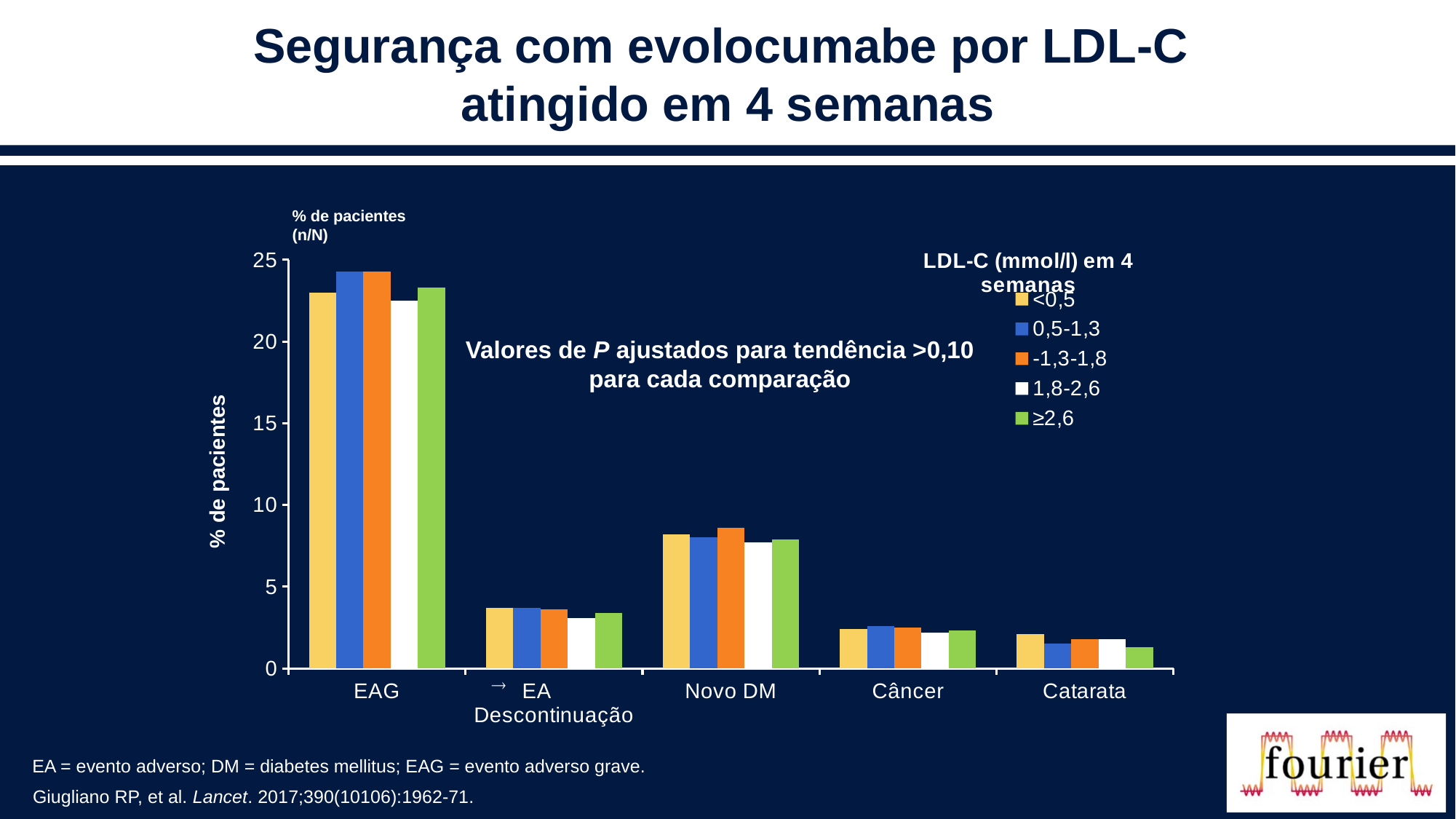
In the <0,5 series, which is larger: the value for EAG or the value for Novo DM? EAG Which category has the tallest bars in the chart? EAG Which category has the shortest bars in the chart? Catarata Is the value for Novo DM in the ≥2,6 series greater or less than 10? less For Catarata, which is larger: the value for the <0,5 series or the ≥2,6 series? <0,5 Is the value for EAG in the <0,5 series greater or less than 20? greater How many series does the chart legend list? 5 How many categories are shown on the x axis of the chart? 5 Is the value for Novo DM in the <0,5 series greater or less than 5? greater What kind of chart is shown on the slide? Bar chart What is the label of the y axis of the chart? % de pacientes